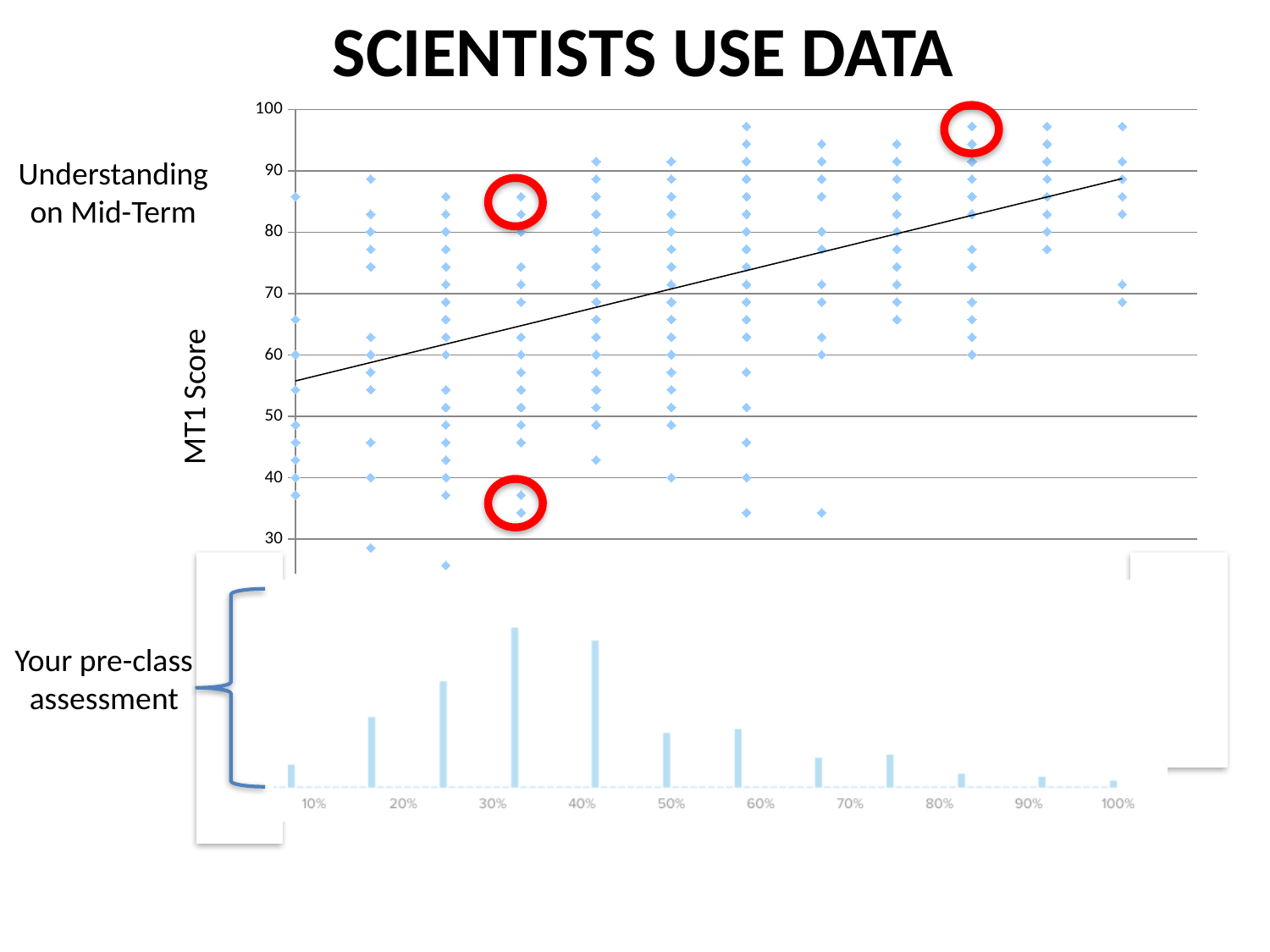
In the upper scatter chart, is the lowest plotted point greater or less than 30? less What is the highest value shown on the y axis of the upper scatter chart? 100 In the upper scatter chart, do MT1 scores generally rise or fall as the pre-class assessment score increases along the x axis? rise What kind of chart is the lower chart on the slide? bar chart In the upper scatter chart, is the highest point in the 100% column greater or less than 90? greater What kind of chart is the upper chart on the slide? scatter chart In the lower bar chart, which is taller: the bar near 30% or the bar near 70%? the bar near 30% What is the y-axis label of the upper scatter chart? MT1 Score In the upper scatter chart, is the right end of the trend line greater or less than 80? greater How many bars are plotted in the lower bar chart? 12 In the lower bar chart, which is taller: the bar near 20% or the bar near 90%? the bar near 20%